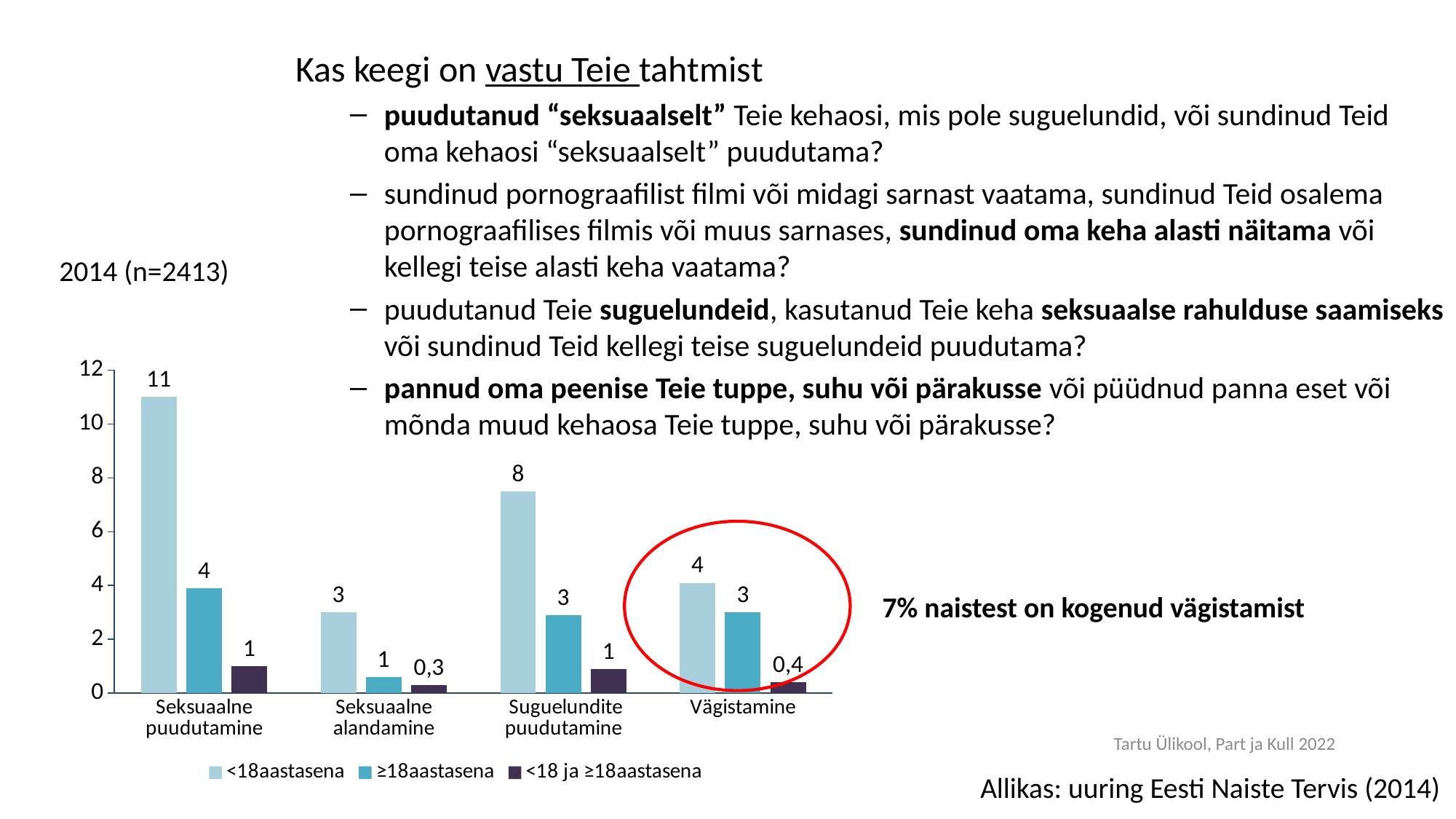
What is the difference between the '<18aastasena' and '≥18aastasena' values in the 'Seksuaalne puudutamine' category? 7 What value is shown for '≥18aastasena' in the 'Vägistamine' category? 3 What type of chart is shown on the slide? Bar chart How many series does the chart legend list? 3 What value is shown for '<18 ja ≥18aastasena' in the 'Seksuaalne alandamine' category? 0,3 Which category on the chart is circled in red? Vägistamine Which category has the lowest value for the '<18 ja ≥18aastasena' series? Seksuaalne alandamine How many categories are shown on the x axis of the chart? 4 What value is shown for '<18 ja ≥18aastasena' in the 'Vägistamine' category? 0,4 Which is larger: the '<18aastasena' value for 'Suguelundite puudutamine' or for 'Vägistamine'? Suguelundite puudutamine What value is shown for '<18aastasena' in the 'Seksuaalne puudutamine' category? 11 Which category has the highest value for the '<18aastasena' series? Seksuaalne puudutamine